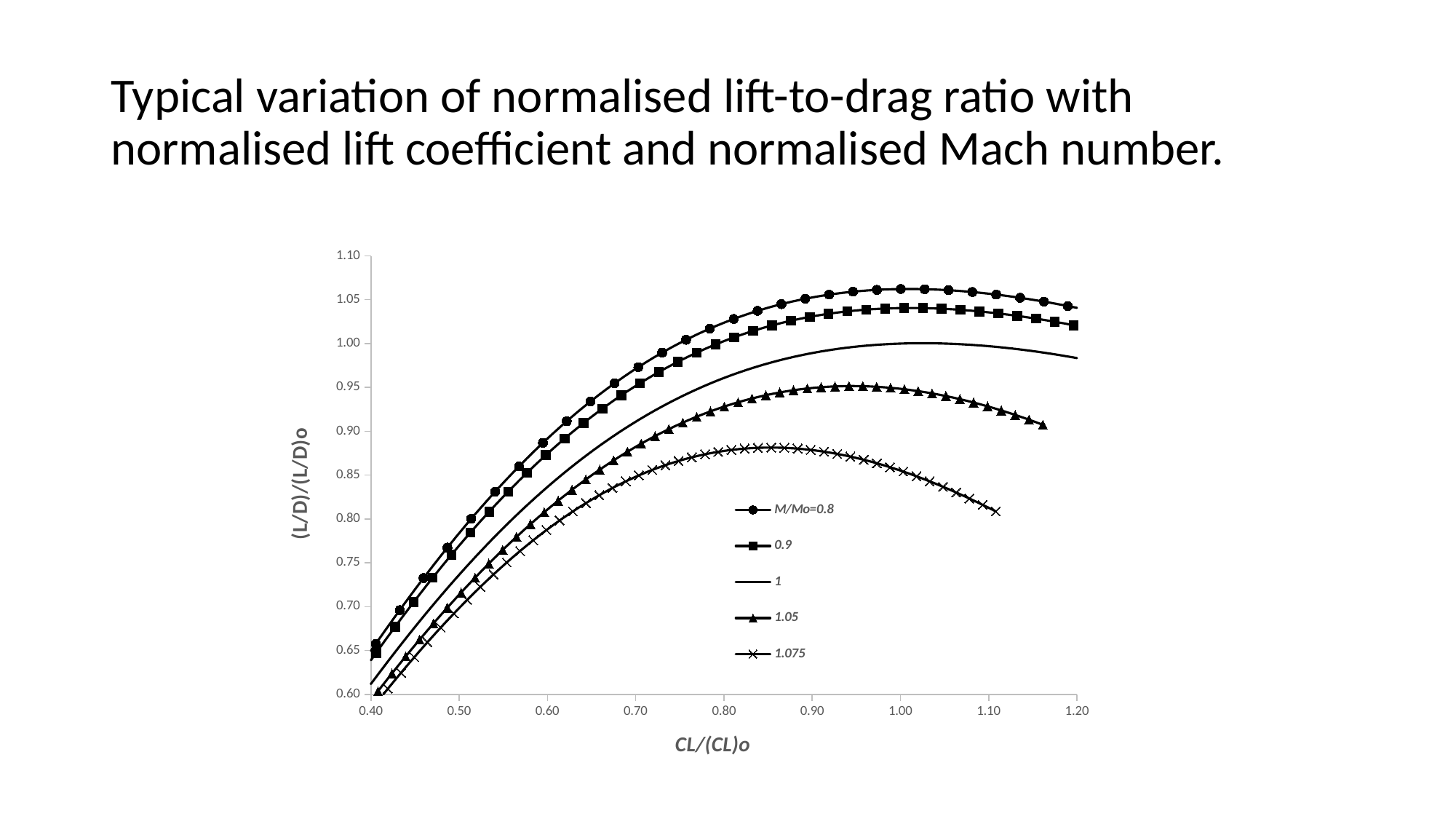
Does the 1.075 series rise or fall as CL/(CL)o increases from 0.40 to 0.80? rise How many series does the legend list? 5 Does the M/Mo=0.8 series rise or fall as CL/(CL)o increases from 1.05 to 1.20? fall Is the peak value of the 1.075 series greater or less than 0.90? less Which series has the lowest peak value of (L/D)/(L/D)o? 1.075 What kind of chart is shown on the slide? line chart Which series reaches the highest value of (L/D)/(L/D)o? M/Mo=0.8 Is the peak value of the 1.05 series greater or less than 0.90? greater At CL/(CL)o = 0.80, which series has the larger value, M/Mo=0.8 or 1.075? M/Mo=0.8 What is the label of the y axis? (L/D)/(L/D)o What is the label of the x axis? CL/(CL)o At CL/(CL)o = 1.00, is the value for the M/Mo=0.8 series greater or less than 1.00? greater